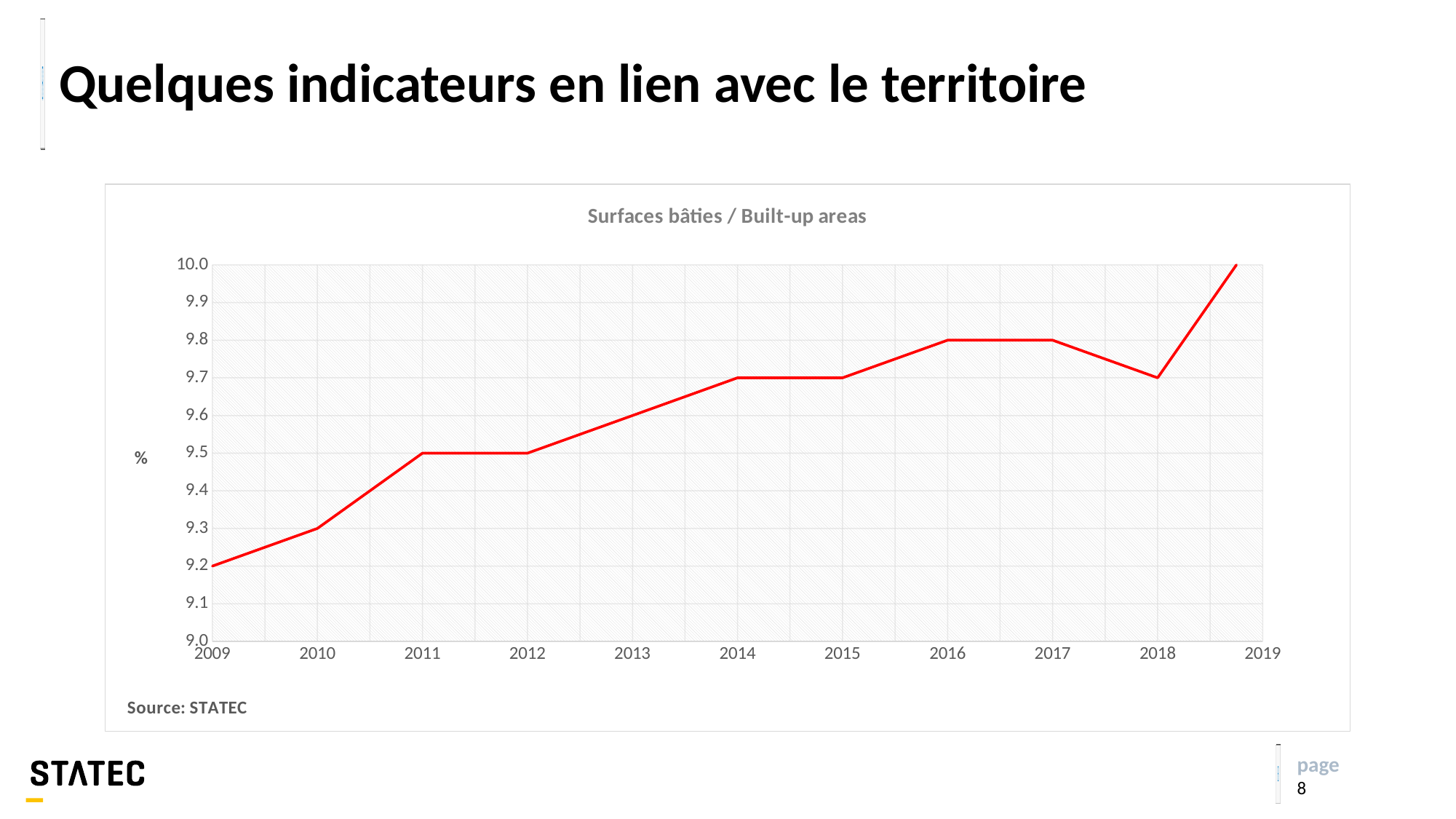
What is the title of the chart? Surfaces bâties / Built-up areas Which year has the highest value? 2019 What is the value for 2009? 9.2 What kind of chart is shown on the slide? line chart Is the value for 2013 greater or less than 9.5? greater Which year has the lowest value? 2009 Which is larger, the value for 2017 or the value for 2018? 2017 What is the value for 2018? 9.7 What is the value for 2016? 9.8 How many years are plotted on the x axis? 11 What is the value for 2011? 9.5